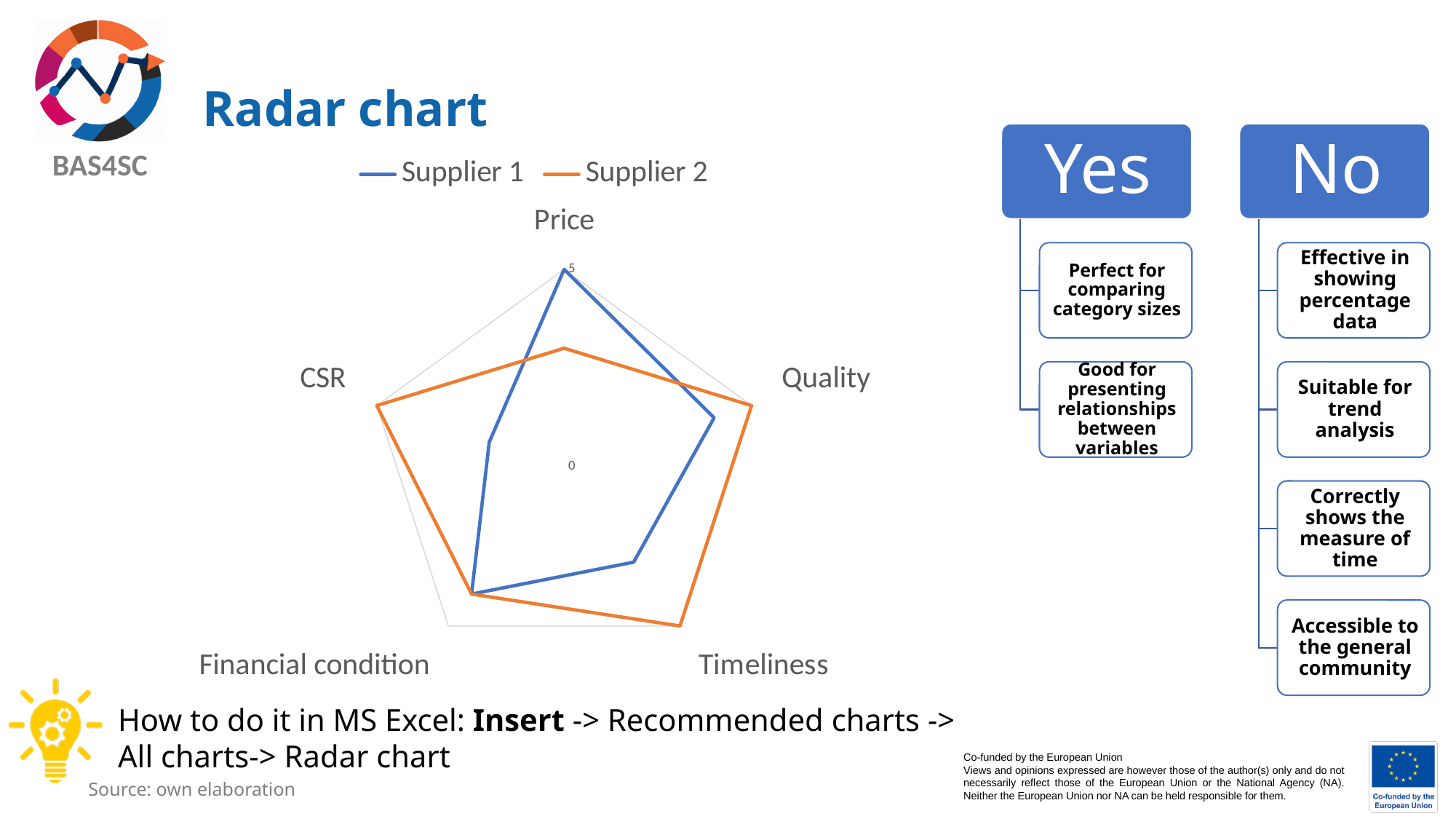
What kind of chart is shown on the slide? Radar chart Which supplier has the larger value on the CSR axis? Supplier 2 Which colour represents Supplier 2 in the chart? Orange What is the value for Supplier 1 on the Price axis? 5 On which axis does Supplier 2 have its lowest value? Price How many categories (axes) does the radar chart have? 5 What is the value for Supplier 2 on the Timeliness axis? 5 On which axis does Supplier 1 have its highest value? Price What is the value for Supplier 2 on the CSR axis? 5 Which supplier has the larger value on the Price axis? Supplier 1 How many series does the chart legend list? 2 What is the value for Supplier 2 on the Quality axis? 5